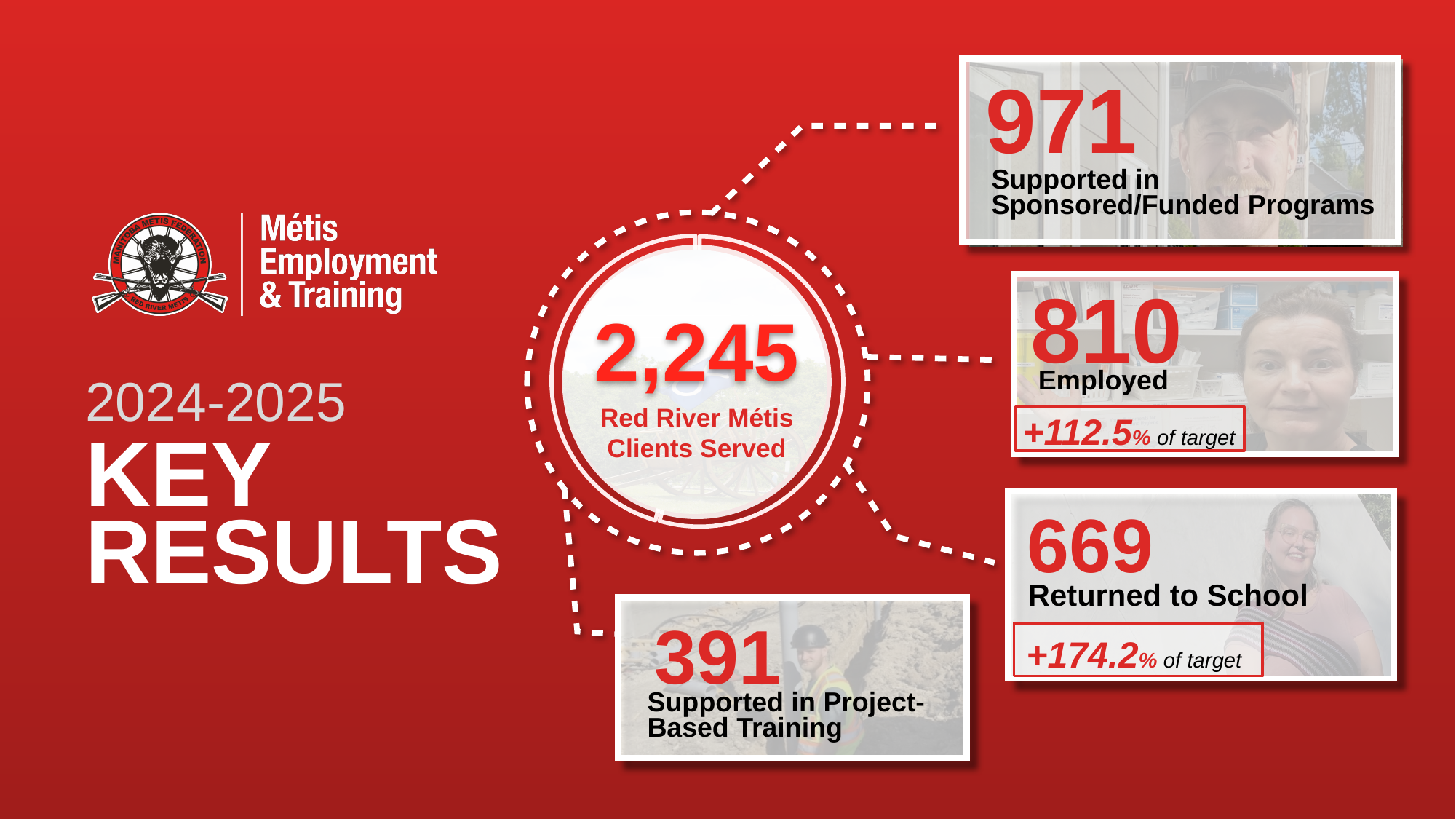
Which is larger: the number supported in Sponsored/Funded Programs or the number supported in Project-Based Training? Supported in Sponsored/Funded Programs What percentage of target does the Returned to School figure represent? +174.2% of target How many clients were supported in Project-Based Training? 391 What is the difference between the number of clients Employed and the number who Returned to School? 141 How many clients Returned to School? 669 Which of the four outcome categories has the lowest number of clients? Supported in Project-Based Training How many clients were Employed? 810 What percentage of target does the Employed figure represent? +112.5% of target How many clients were supported in Sponsored/Funded Programs? 971 Which of the four outcome categories has the highest number of clients? Supported in Sponsored/Funded Programs How many outcome categories are connected to the central clients-served figure? 4 How many Red River Métis clients were served in 2024-2025 according to the central figure? 2,245